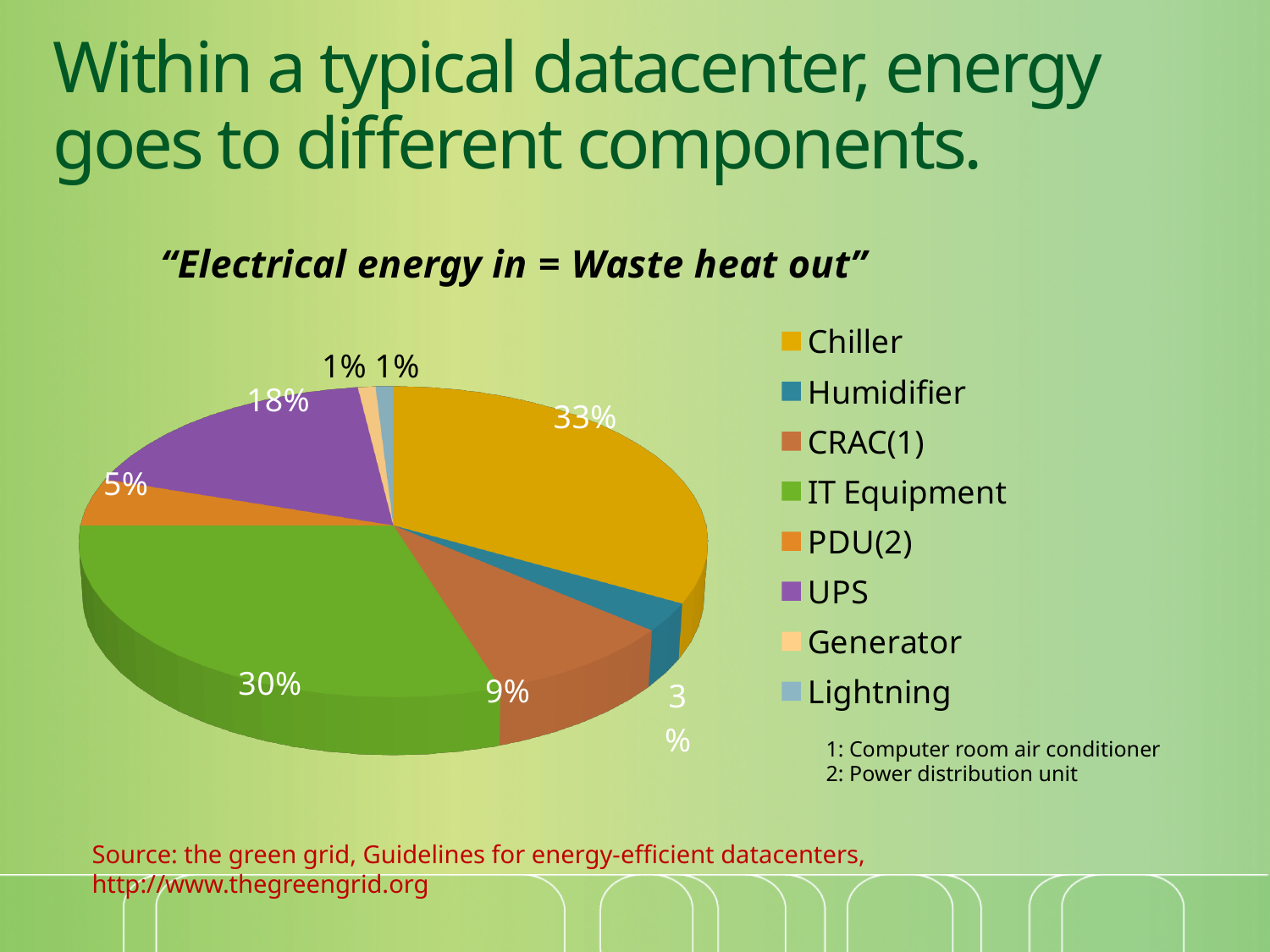
What share of energy goes to IT Equipment? 30% Which receives a larger share of energy, UPS or CRAC(1)? UPS Which component receives the largest share of energy? Chiller What share of energy goes to the Chiller? 33% What kind of chart is shown on the slide? pie chart What share of energy goes to the Humidifier? 3% What colour represents IT Equipment in the pie chart? green How many components are listed in the legend? 8 What share of energy goes to UPS? 18% What is the difference in percentage points between the Chiller share and the IT Equipment share? 3 What share of energy goes to CRAC(1)? 9% What share of energy goes to PDU(2)? 5%